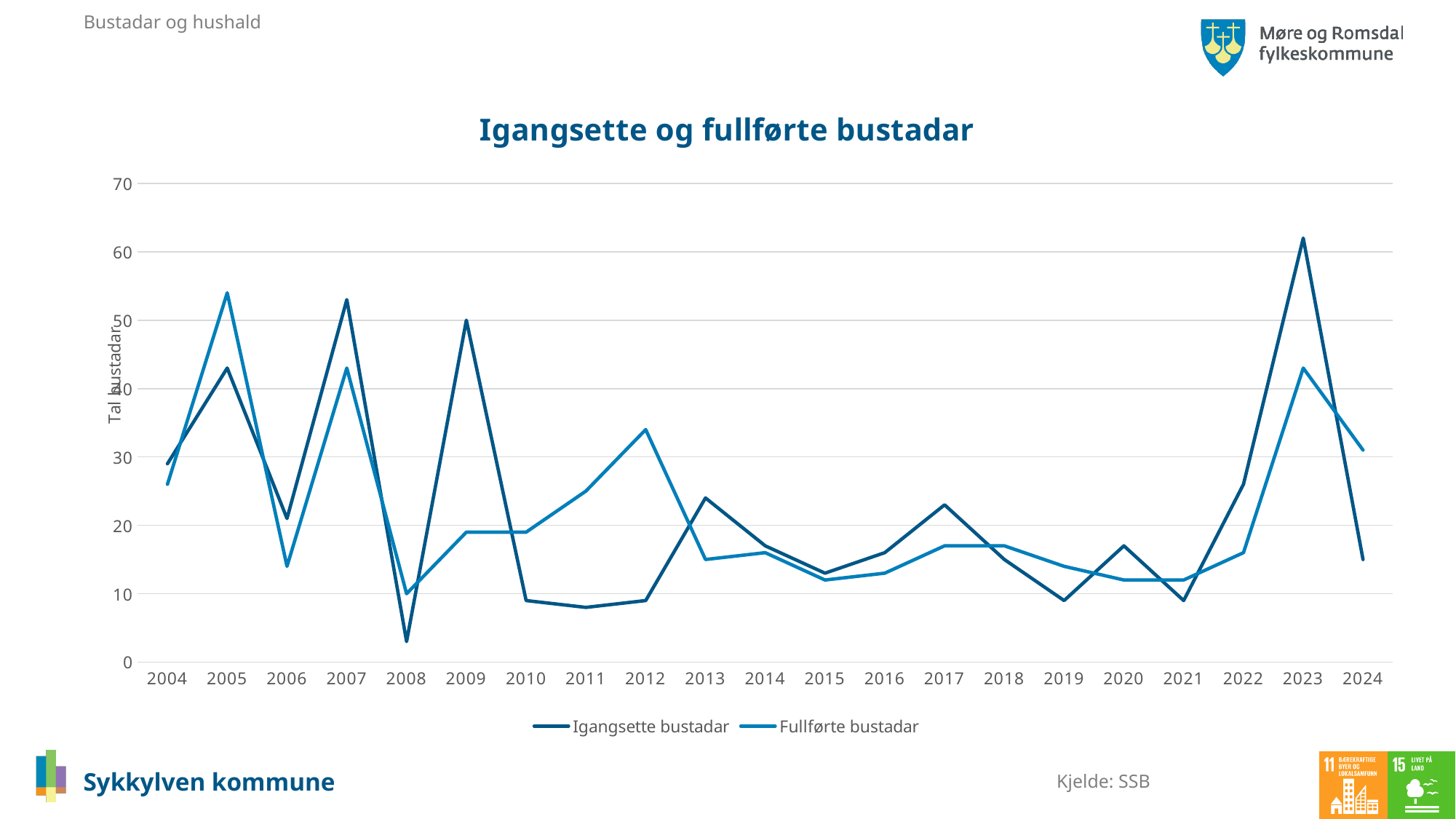
In which year is the value for Igangsette bustadar highest? 2023 In which year is the value for Fullførte bustadar highest? 2005 In 2012, which series has the larger value, Igangsette bustadar or Fullførte bustadar? Fullførte bustadar How many series does the legend list? 2 What is the title of the chart? Igangsette og fullførte bustadar How many years are shown on the x axis? 21 In which year is the value for Igangsette bustadar lowest? 2008 In 2009, which series has the larger value, Igangsette bustadar or Fullførte bustadar? Igangsette bustadar What kind of chart is shown on the slide? line chart Is the value for Igangsette bustadar in 2008 greater or less than 10? less Is the value for Fullførte bustadar in 2005 greater or less than 50? greater Is the value for Igangsette bustadar in 2023 greater or less than 60? greater